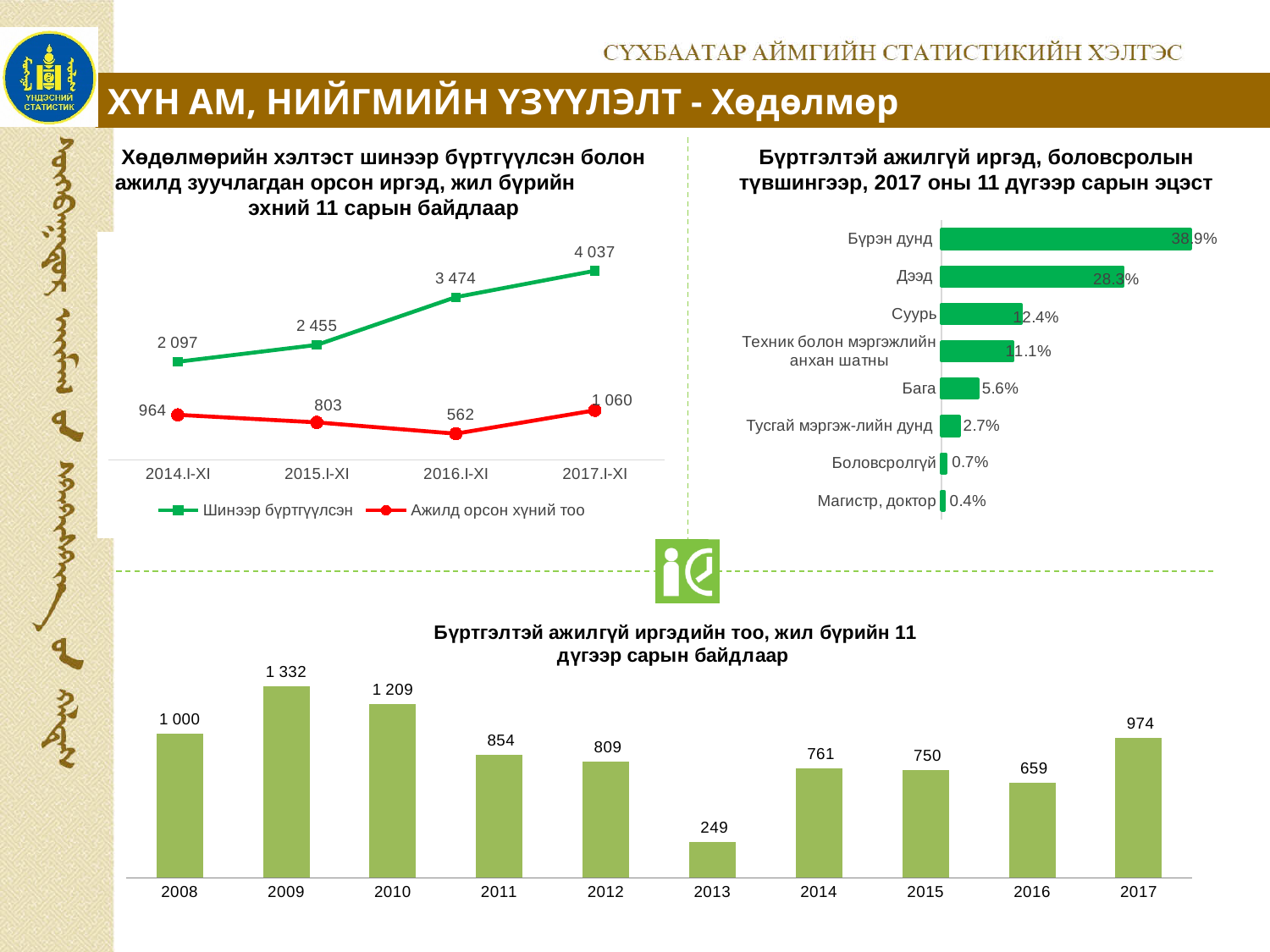
In the top-left line chart, does the 'Шинээр бүртгүүлсэн' series rise or fall from 2014.I-XI to 2017.I-XI? rise In the bottom bar chart, which is larger, the value for 2014 or the value for 2016? 2014 In the top-right bar chart, which category has the lowest value? Магистр, доктор In the top-right bar chart, which category has the highest value? Бүрэн дунд In the bottom bar chart, what is the value for 2013? 249 In the top-left line chart, what is the value for 'Шинээр бүртгүүлсэн' in 2017.I-XI? 4 037 In the top-right bar chart, how many categories are shown? 8 In the top-left line chart, what is the difference between 'Шинээр бүртгүүлсэн' and 'Ажилд орсон хүний тоо' in 2014.I-XI? 1 133 In the top-left line chart, how many series does the legend list? 2 In the top-left line chart, what is the value for 'Ажилд орсон хүний тоо' in 2016.I-XI? 562 In the bottom bar chart, which year has the highest value? 2009 In the top-right bar chart, what is the value for 'Дээд'? 28.3%